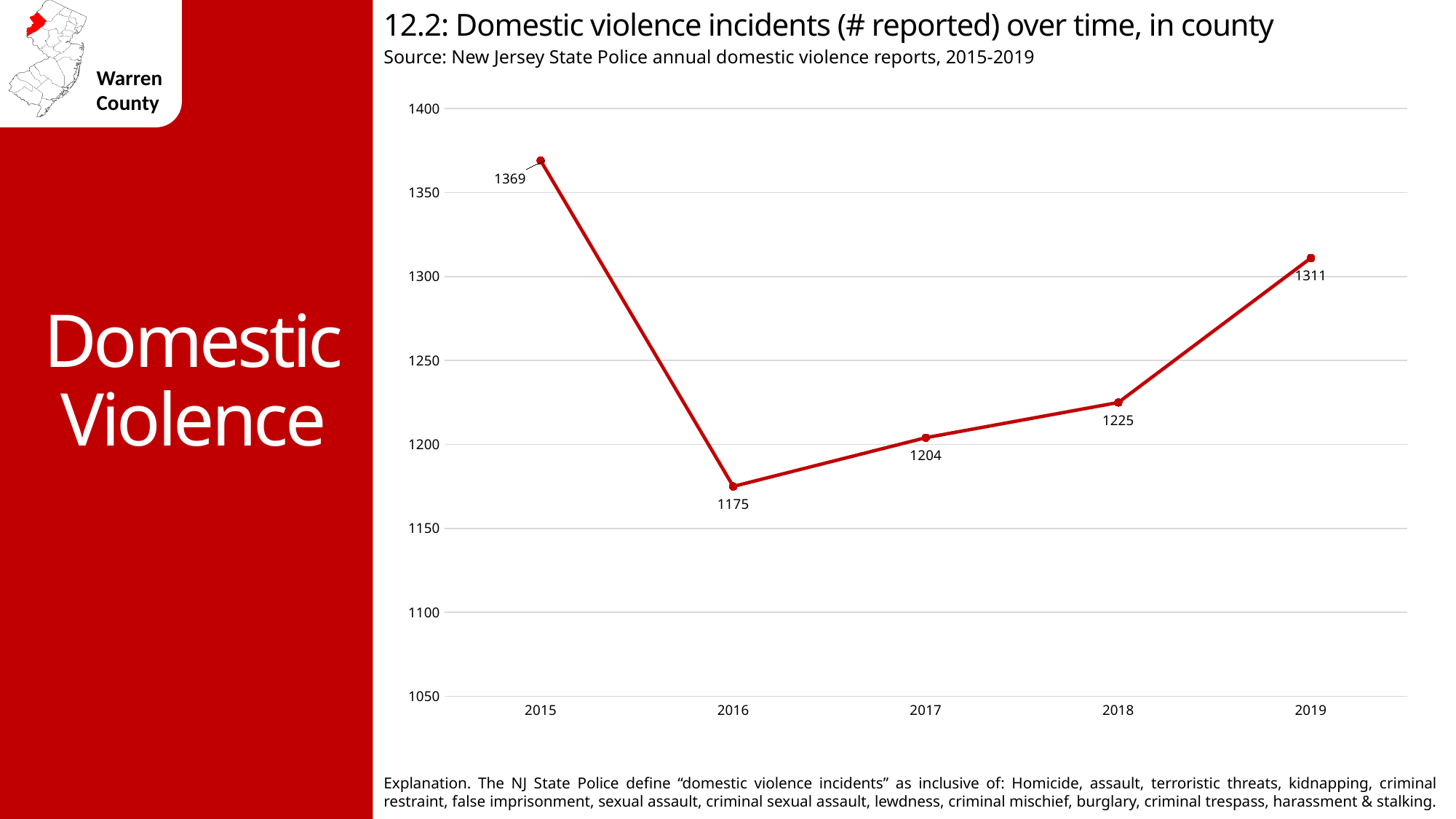
What was the number of reported domestic violence incidents in 2015? 1369 What was the number of reported domestic violence incidents in 2017? 1204 How many years are plotted on the chart? 5 Which year had more reported incidents, 2017 or 2018? 2018 What is the difference between the number of incidents in 2015 and 2016? 194 What is the difference between the number of incidents in 2019 and 2018? 86 Which year had the highest number of reported domestic violence incidents? 2015 Which year had the lowest number of reported domestic violence incidents? 2016 What kind of chart is shown on the slide? line chart What was the number of reported domestic violence incidents in 2019? 1311 Did the number of reported incidents rise or fall from 2016 to 2019? rise Is the value for 2018 greater or less than 1250? less